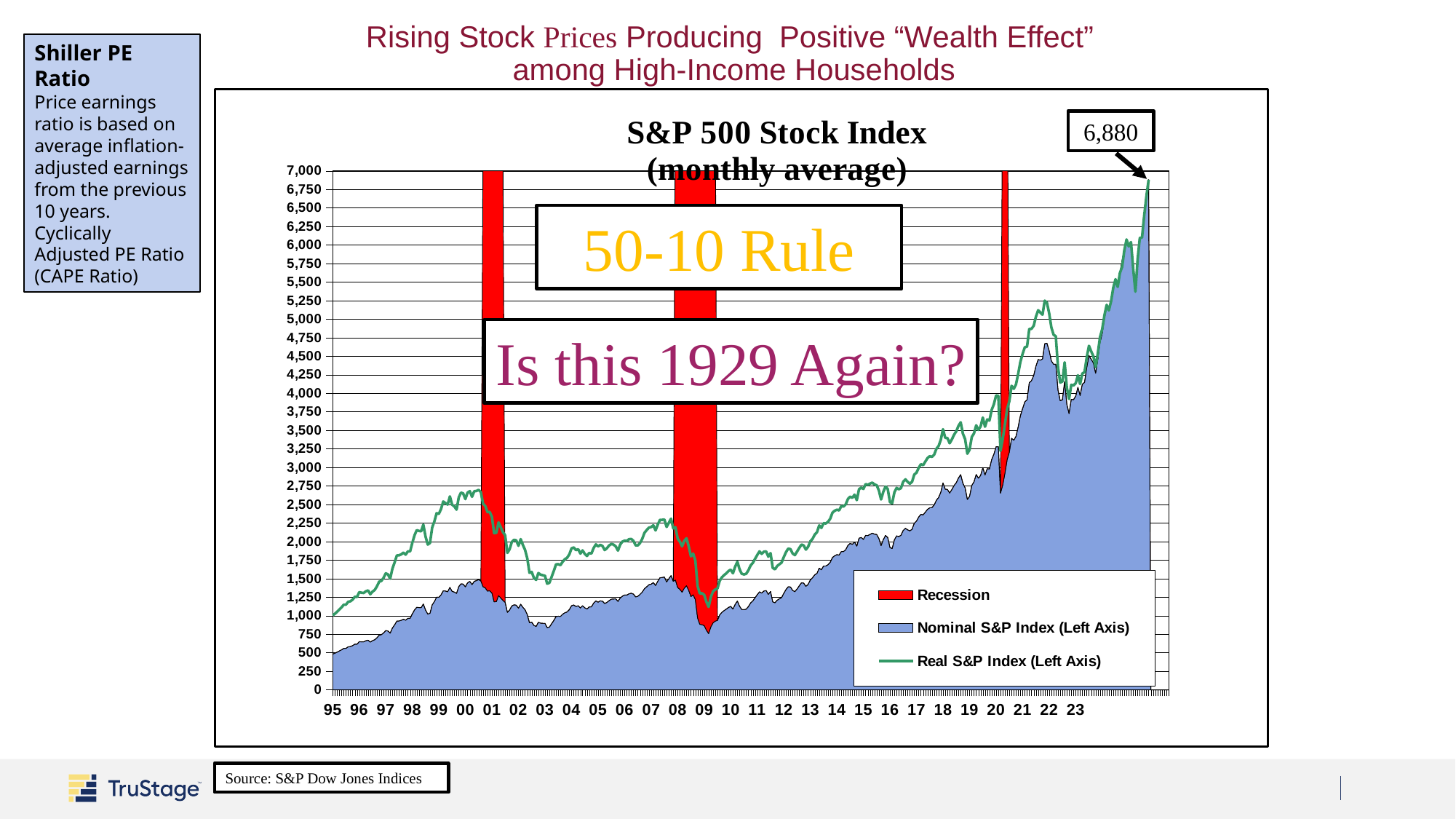
Does the Nominal S&P Index generally rise or fall from 1995 to the end of the chart? rise What value is labeled at the end of the S&P 500 index series? 6,880 Is the value of the Nominal S&P Index at its 2009 low greater or less than 1,000? less What does the red shading on the chart represent? Recession What is the title of the chart? S&P 500 Stock Index (monthly average) Is the value of the Real S&P Index at its 2000 peak greater or less than 2,000? greater Is the value of the Nominal S&P Index in 1995 greater or less than 1,000? less How many red recession bars are shown on the chart? 3 In 2000, which is higher: the Real S&P Index or the Nominal S&P Index? Real S&P Index What kind of chart is used to show the S&P 500 Stock Index? area and line chart How many entries does the chart's legend list? 3